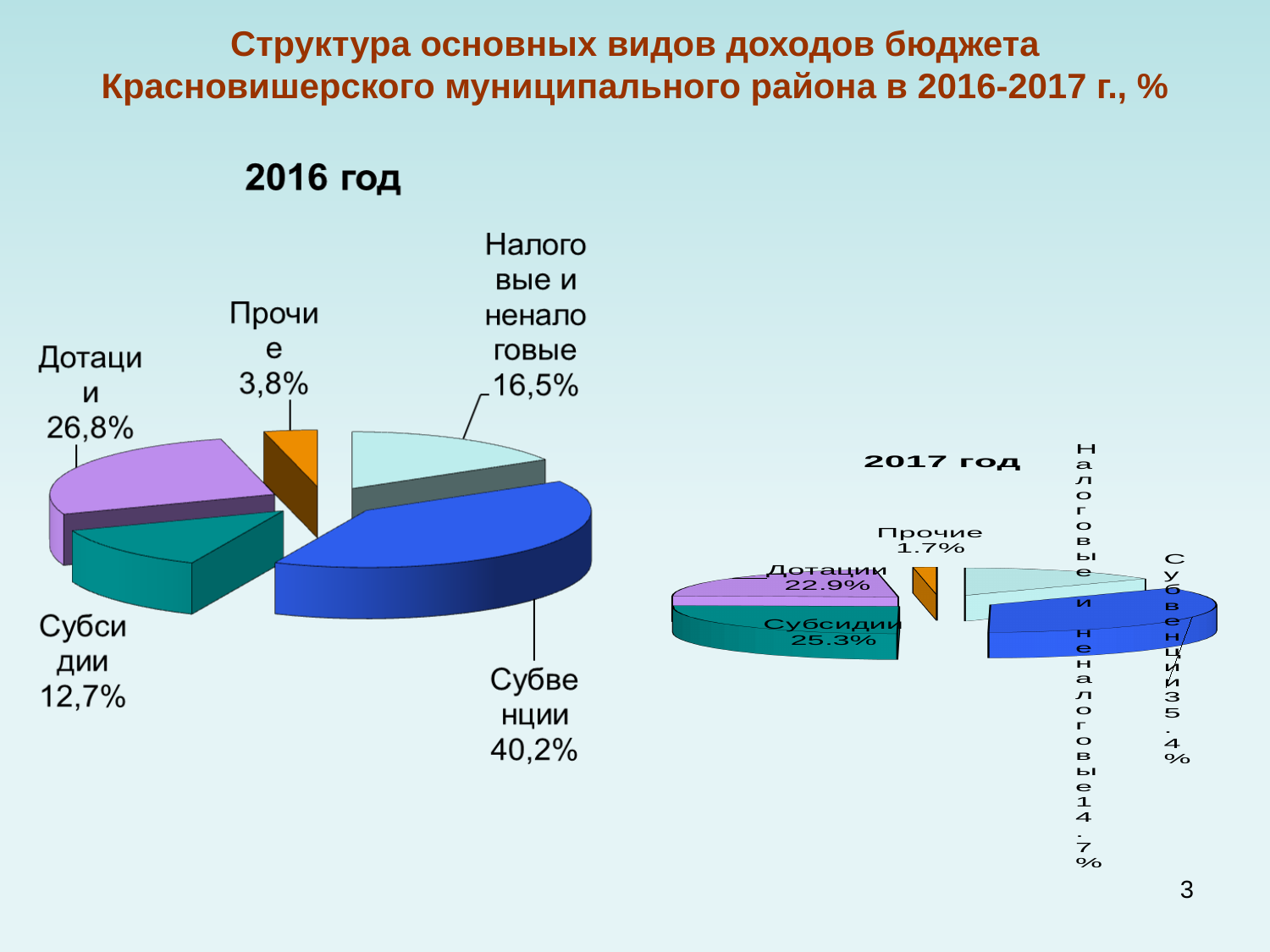
In the 2016 год chart, which is larger: Налоговые и неналоговые or Субсидии? Налоговые и неналоговые In the 2017 год chart, which category has the largest share? Субвенции In the 2016 год chart, what share do Субвенции have? 40,2% In the 2017 год chart, what is the value for Субсидии? 25.3% In the 2016 год chart, what is the value for Дотации? 26,8% In the 2017 год chart, what is the value for Прочие? 1.7% How many categories are shown in the 2016 год chart? 5 In the 2017 год chart, what is the value for Дотации? 22.9% In the 2016 год chart, what is the difference between Дотации and Субсидии? 14,1% In the 2016 год chart, which category has the largest share? Субвенции What type of chart is the 2016 год chart? Pie chart In the 2016 год chart, which category has the smallest share? Прочие